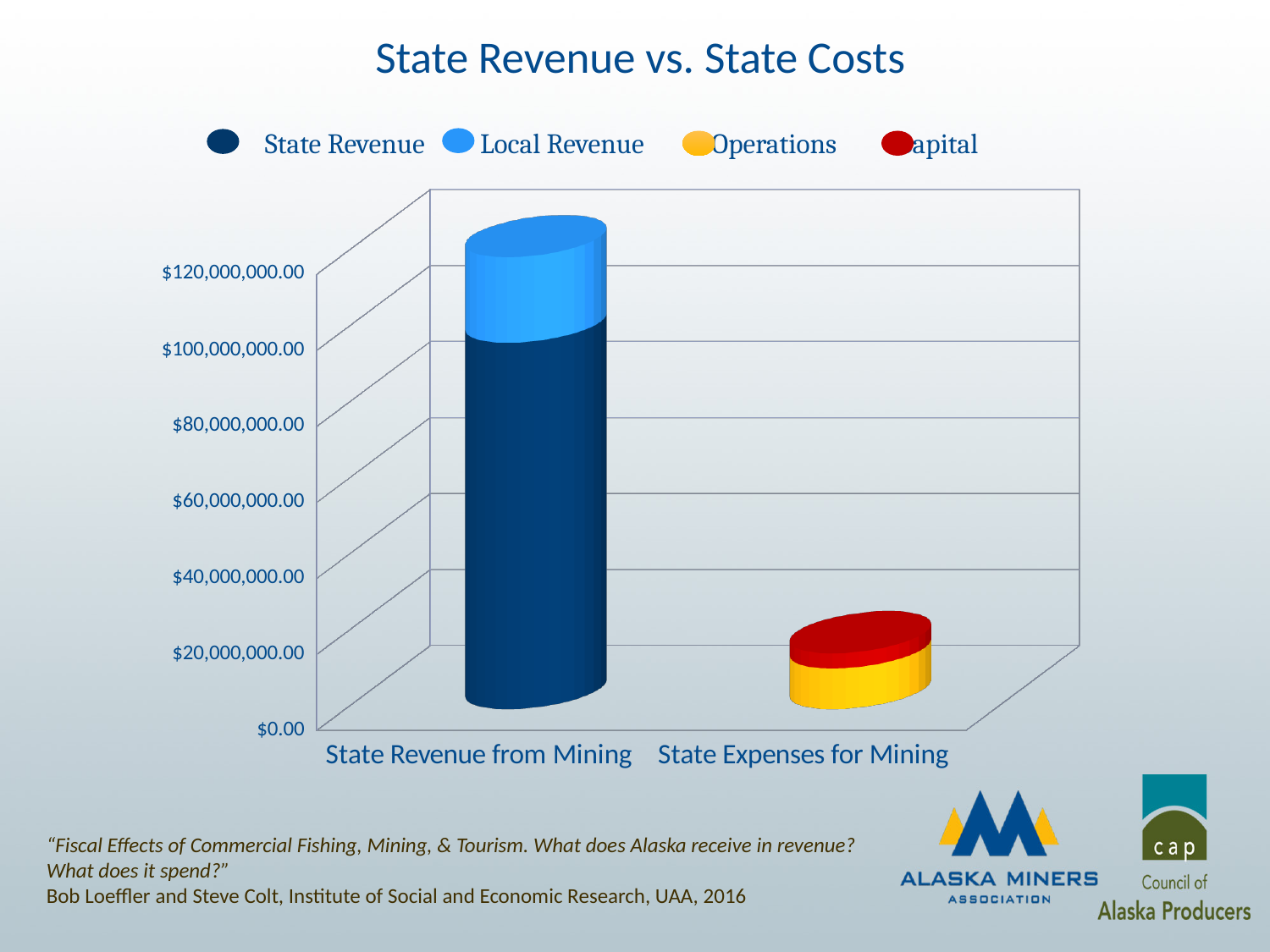
What kind of chart is shown on the slide? Bar chart Which category has the taller stacked bar, State Revenue from Mining or State Expenses for Mining? State Revenue from Mining What is the title of the chart? State Revenue vs. State Costs Which category has the lowest stacked total? State Expenses for Mining Is the stacked total for State Revenue from Mining greater or less than $80,000,000.00? greater Do the stacked bar totals rise or fall from left to right along the x axis? fall Which series is shown in yellow in the chart's legend? Operations How many series does the chart's legend list? 4 How many categories are shown on the x axis of the chart? 2 Which category has the highest stacked total? State Revenue from Mining Is the stacked total for State Expenses for Mining greater or less than $40,000,000.00? less